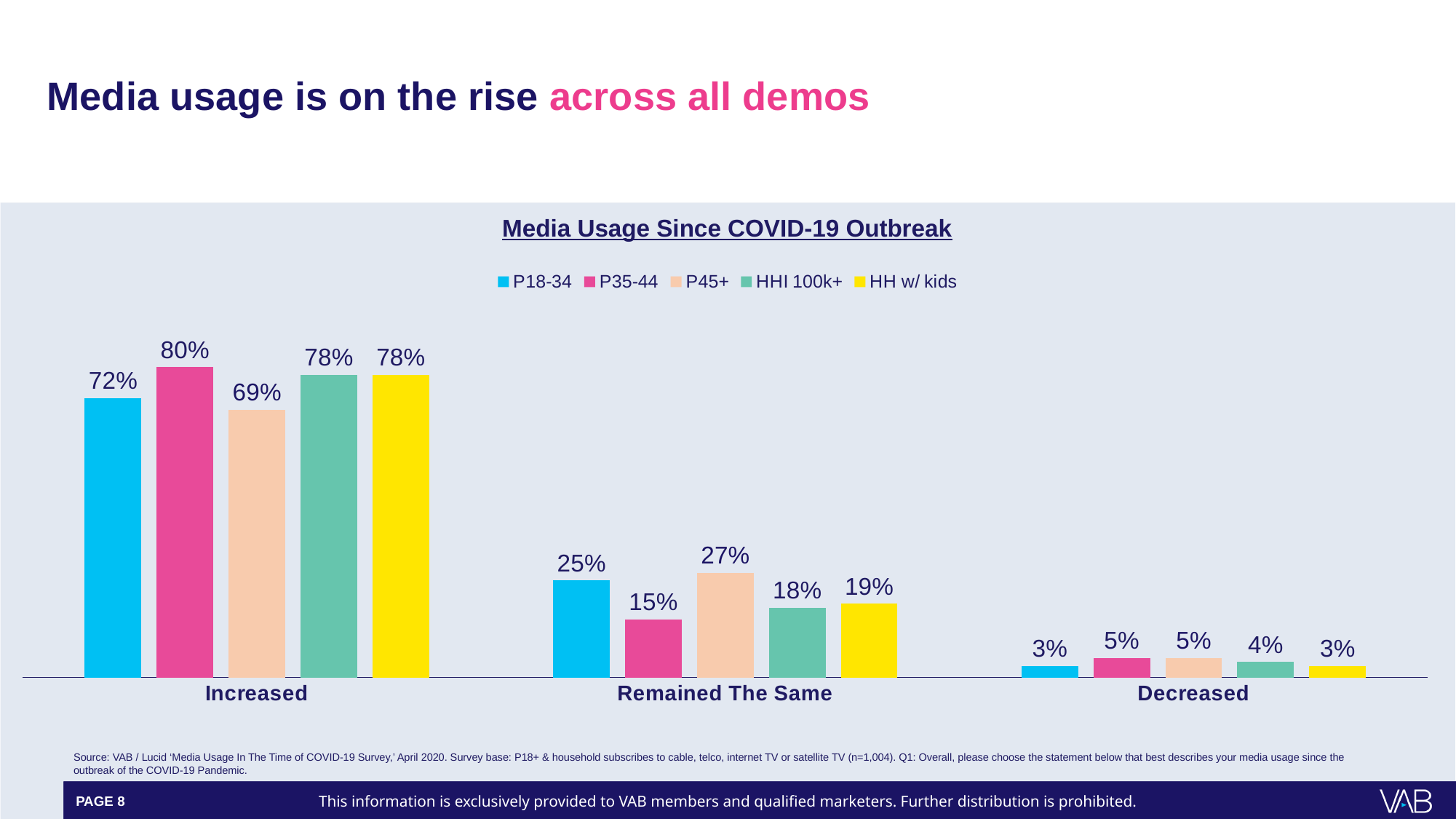
What is the title of the chart? Media Usage Since COVID-19 Outbreak Which colour represents the HH w/ kids series? Yellow What is the value for P45+ in the Remained The Same category? 27% How many categories are shown on the x axis? 3 What is the value for HHI 100k+ in the Decreased category? 4% Which is larger in the Remained The Same category: P18-34 or HH w/ kids? P18-34 What kind of chart is shown on the slide? Bar chart How many series does the legend list? 5 Which demo has the lowest value in the Remained The Same category? P35-44 What is the difference between the P35-44 and P45+ values in the Increased category? 11% What percentage of P35-44 reported their media usage Increased? 80% Which demo has the highest value in the Increased category? P35-44